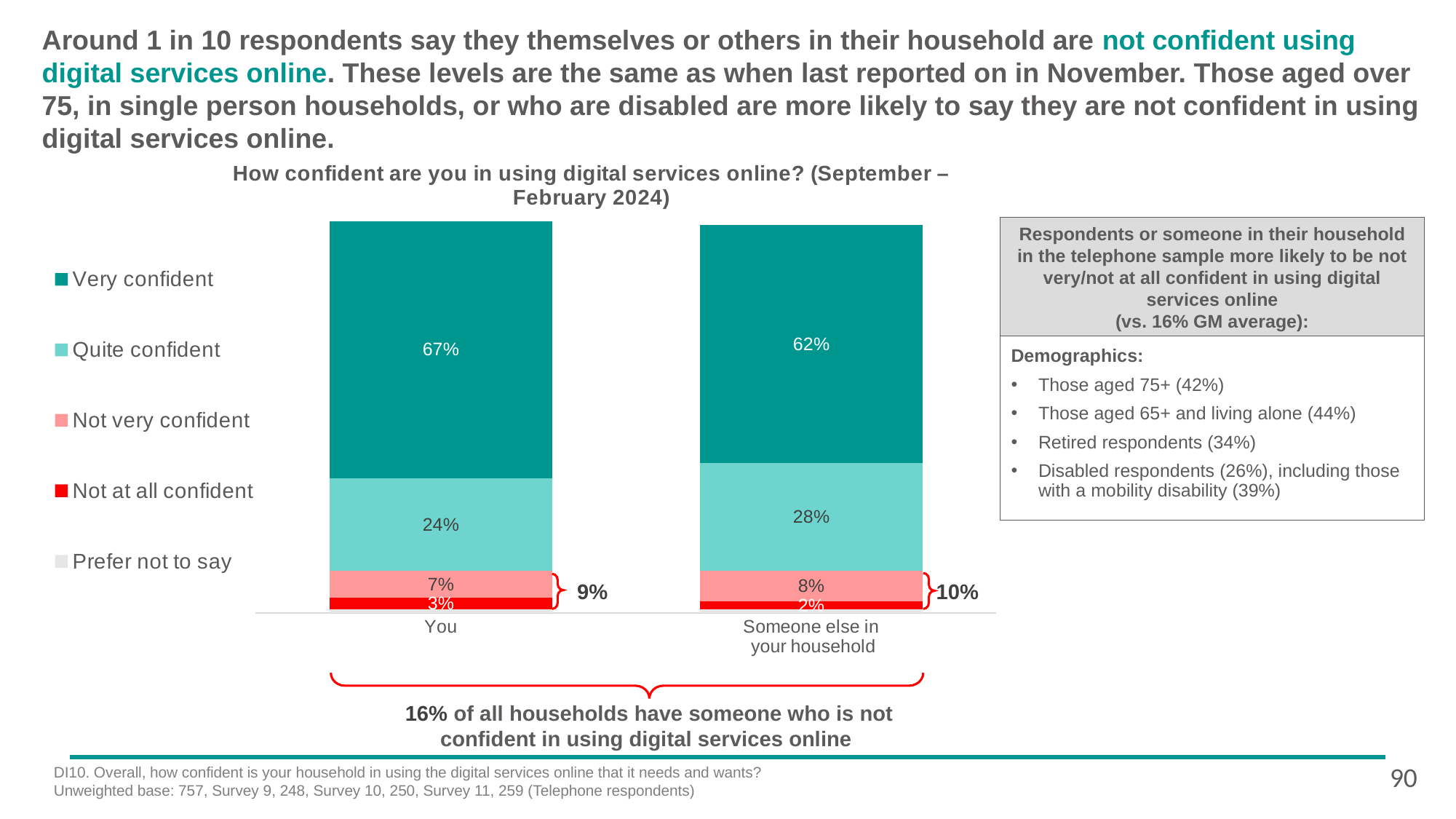
What is the 'Not very confident' value for the 'You' bar? 7% What is the combined share of 'Not very confident' and 'Not at all confident' for the 'Someone else in your household' bar, as shown by the bracket label? 10% What is the difference between the 'Quite confident' values for 'Someone else in your household' and 'You'? 4 percentage points What percentage of respondents say someone else in their household is quite confident in using digital services online? 28% Which legend entry is shown in red? Not at all confident What percentage of respondents say they themselves are very confident in using digital services online? 67% What type of chart is shown on the slide? Stacked bar chart What is the combined share of 'Not very confident' and 'Not at all confident' for the 'You' bar, as shown by the bracket label? 9% What is the 'Not at all confident' value for the 'Someone else in your household' bar? 2% How many series does the legend list? 5 How many bars (categories) are shown on the chart? 2 Which bar has the higher 'Very confident' value, 'You' or 'Someone else in your household'? You